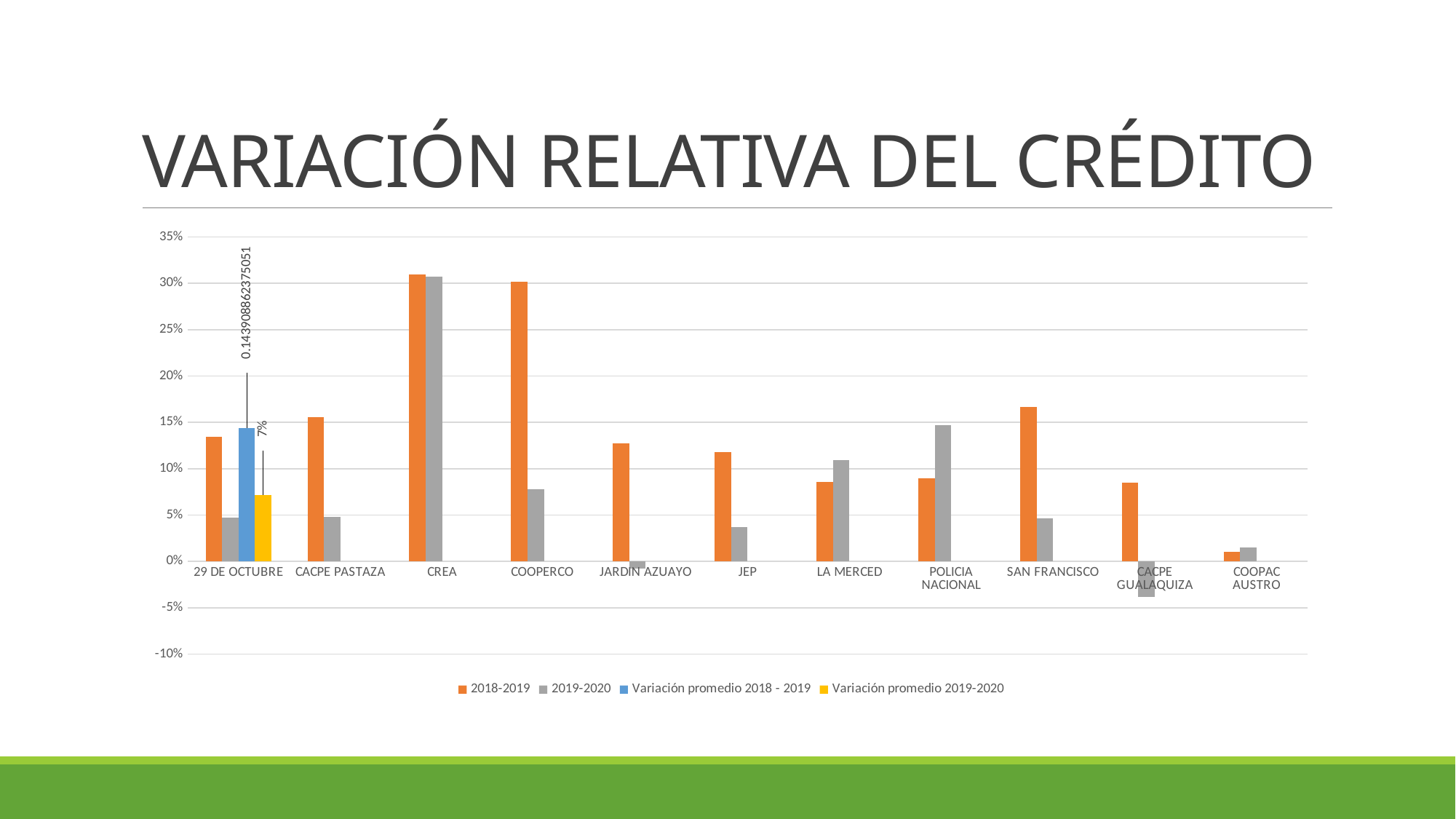
What type of chart is shown on the slide? bar chart How many cooperatives (categories) are shown on the x axis? 11 What value is labelled on the Variación promedio 2019-2020 bar? 7% Which cooperative has the lowest 2019-2020 value? CACPE GUALAQUIZA For LA MERCED, which is larger: the 2018-2019 value or the 2019-2020 value? 2019-2020 What value is labelled on the Variación promedio 2018 - 2019 bar? 0.143908862375051 Is the 2018-2019 value for COOPERCO greater or less than 25%? greater Is the 2019-2020 value for JEP greater or less than 5%? less What is the title of the chart? VARIACIÓN RELATIVA DEL CRÉDITO How many series does the legend list? 4 Which cooperative has the lowest 2018-2019 value? COOPAC AUSTRO Which cooperative has the highest 2019-2020 value? CREA